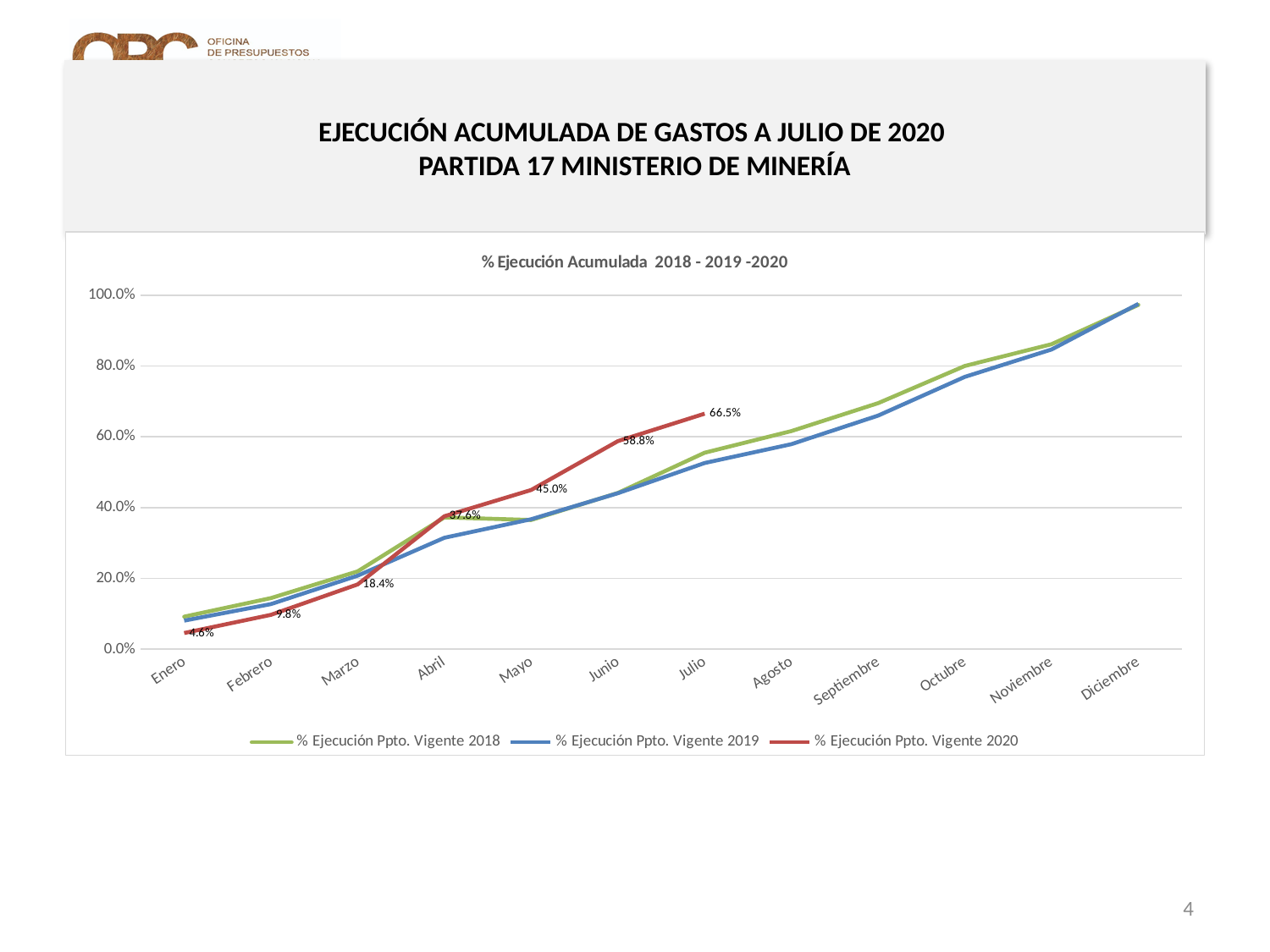
What is the value of % Ejecución Ppto. Vigente 2020 for Mayo? 45.0% Do the values of % Ejecución Ppto. Vigente 2019 rise or fall from Enero to Diciembre? Rise In Julio, which series has the higher value: % Ejecución Ppto. Vigente 2020 or % Ejecución Ppto. Vigente 2019? % Ejecución Ppto. Vigente 2020 Is the value of % Ejecución Ppto. Vigente 2019 for Diciembre greater or less than 80.0%? greater What is the title of the chart? % Ejecución Acumulada 2018 - 2019 -2020 What is the value of % Ejecución Ppto. Vigente 2020 for Marzo? 18.4% How many months are shown on the x axis? 12 By how many percentage points did % Ejecución Ppto. Vigente 2020 increase from Junio to Julio? 7.7 What kind of chart is shown on the slide? Line chart How many series does the legend list? 3 What is the value of % Ejecución Ppto. Vigente 2020 for Julio? 66.5% What is the value of % Ejecución Ppto. Vigente 2020 for Enero? 4.6%